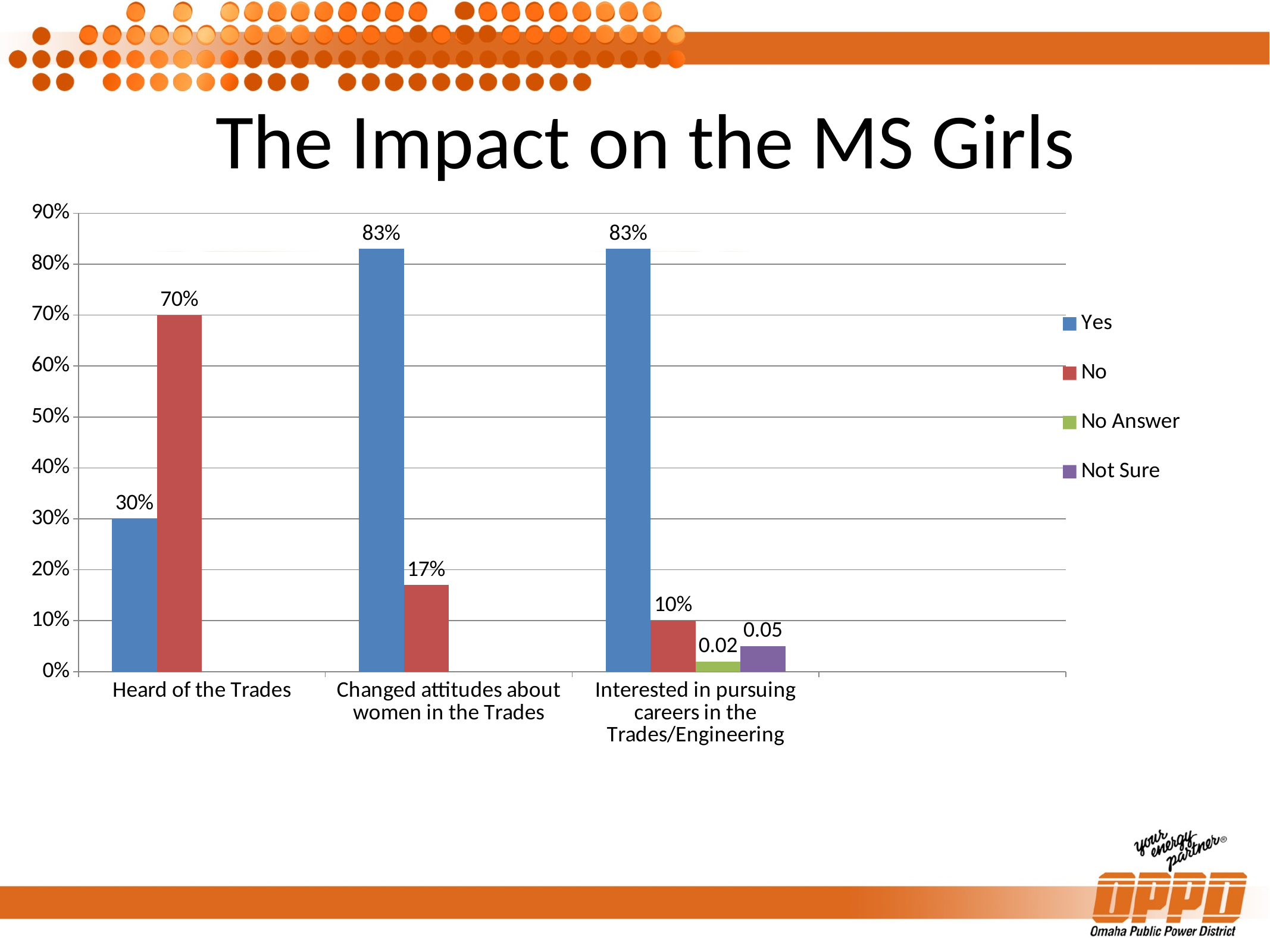
Which category has the highest No value? Heard of the Trades Is the Yes value larger for Heard of the Trades or for Changed attitudes about women in the Trades? Changed attitudes about women in the Trades How many series does the legend list? 4 What is the value for Yes in the Heard of the Trades category? 30% What is the value for No in the Changed attitudes about women in the Trades category? 17% What is the difference between the No and Yes values in the Heard of the Trades category? 40% How many categories are shown on the x axis? 3 What kind of chart is shown on the slide? Bar chart What is the value for Not Sure in the Interested in pursuing careers in the Trades/Engineering category? 0.05 Which category has the lowest Yes value? Heard of the Trades What is the value for No in the Heard of the Trades category? 70% What is the value for No Answer in the Interested in pursuing careers in the Trades/Engineering category? 0.02